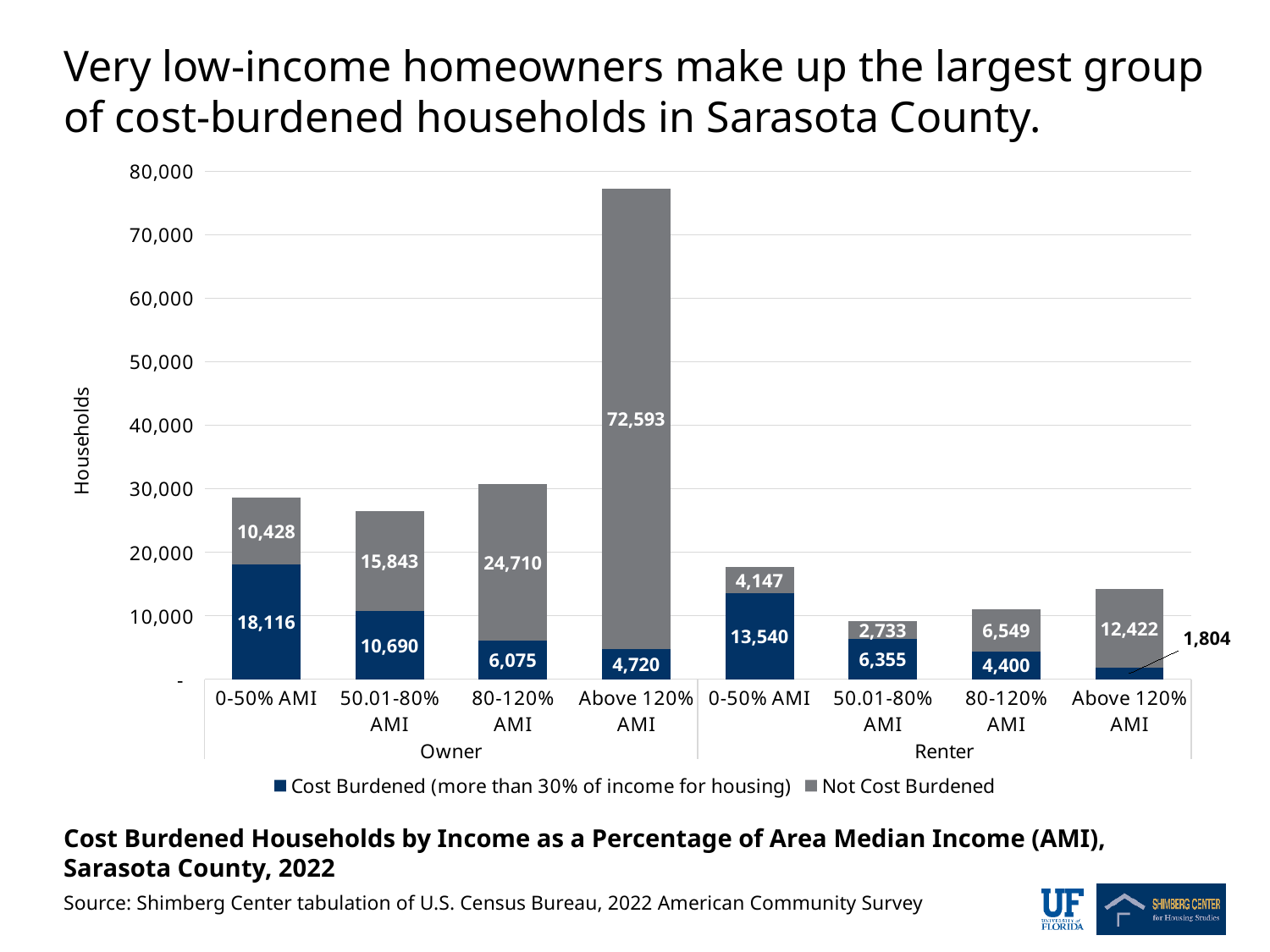
What is the number of cost-burdened owner households in the 0-50% AMI group? 18,116 What is the total number of owner households in the Above 120% AMI group? 77,313 Which income group has the lowest number of cost-burdened households? Above 120% AMI (Renter) What is the number of cost-burdened renter households in the Above 120% AMI group? 1,804 Which is larger: the number of not cost-burdened renter households in the 80-120% AMI group or in the 50.01-80% AMI group? 80-120% AMI What type of chart is shown on the slide? Stacked bar chart What is the difference between cost-burdened owner households and cost-burdened renter households in the 0-50% AMI group? 4,576 What is the number of not cost-burdened owner households in the Above 120% AMI group? 72,593 How many income-group bars are shown in the chart? 8 What is the total number of renter households in the 0-50% AMI group? 17,687 How many series does the legend list? 2 Which income group has the highest number of cost-burdened households? 0-50% AMI (Owner)